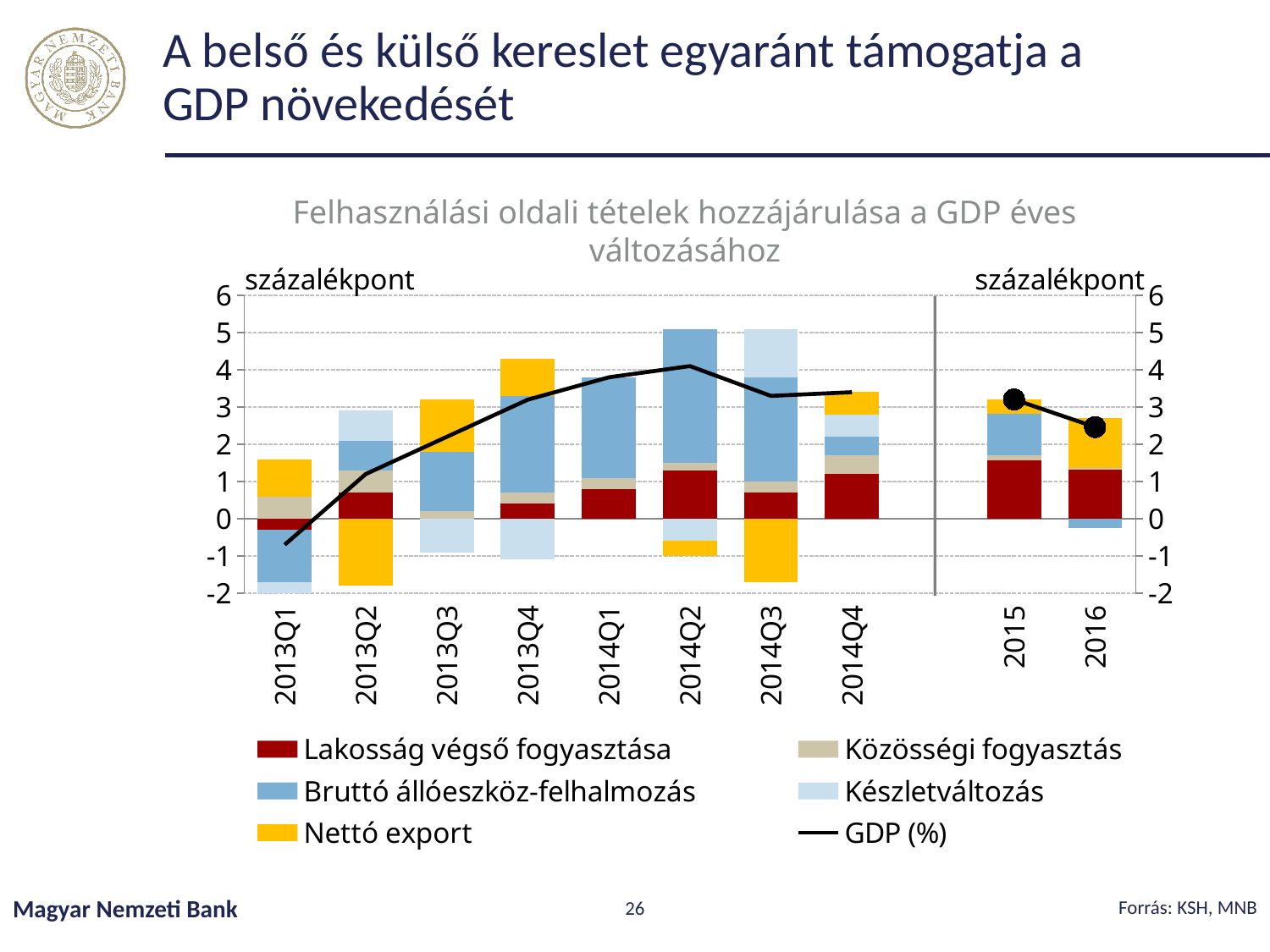
Is the GDP (%) value for 2013Q1 greater or less than 0? less In which period is the GDP (%) line at its lowest? 2013Q1 Is the GDP (%) value for 2014Q1 greater or less than 3? greater What unit label is shown on the vertical axes? százalékpont What is the title of the chart? Felhasználási oldali tételek hozzájárulása a GDP éves változásához What kind of chart is shown on the slide? Stacked bar chart with a line Which has the larger GDP (%) value, 2015 or 2016? 2015 Is the Nettó export contribution for 2013Q2 greater or less than 0? less Does the GDP (%) line rise or fall from 2013Q1 to 2014Q2? rise How many time periods are shown on the x axis? 10 How many series does the legend list? 6 In which period is the GDP (%) line at its highest? 2014Q2